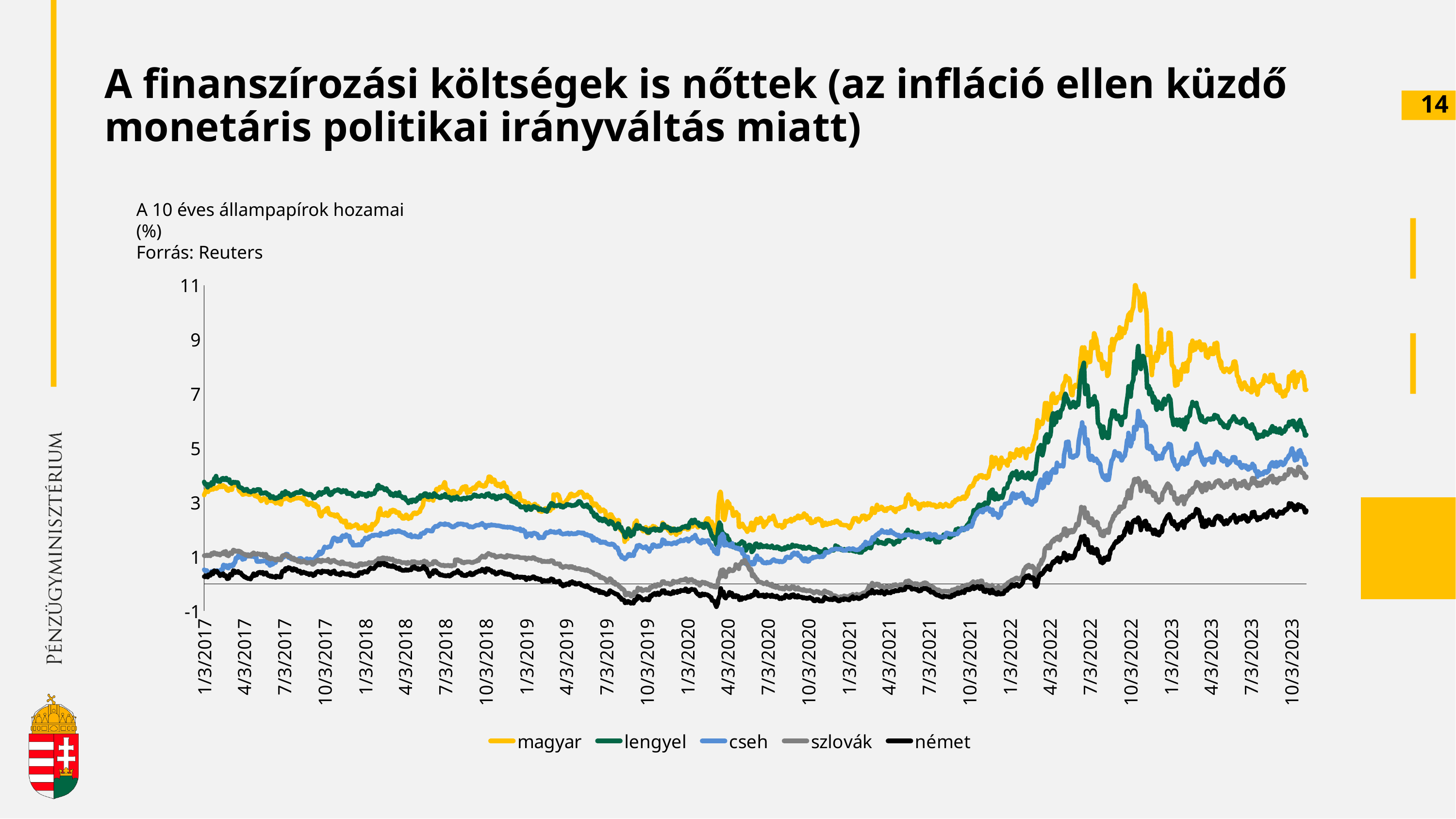
Is the value for szlovák at 10/3/2023 greater or less than 3? greater Is the peak value of the magyar series greater or less than 9? greater What is the highest tick value shown on the vertical axis? 11 Which series reaches the highest value anywhere on the chart? magyar At 10/3/2023, which is higher: lengyel or cseh? lengyel What kind of chart is shown on the slide? line chart Is the value for német at 1/3/2020 greater or less than 1? less How many series does the legend list? 5 Which series has the lowest value at the right end of the chart (10/3/2023)? német Does the magyar series rise or fall between 1/3/2022 and 10/3/2022? rise Which series is drawn in black? német